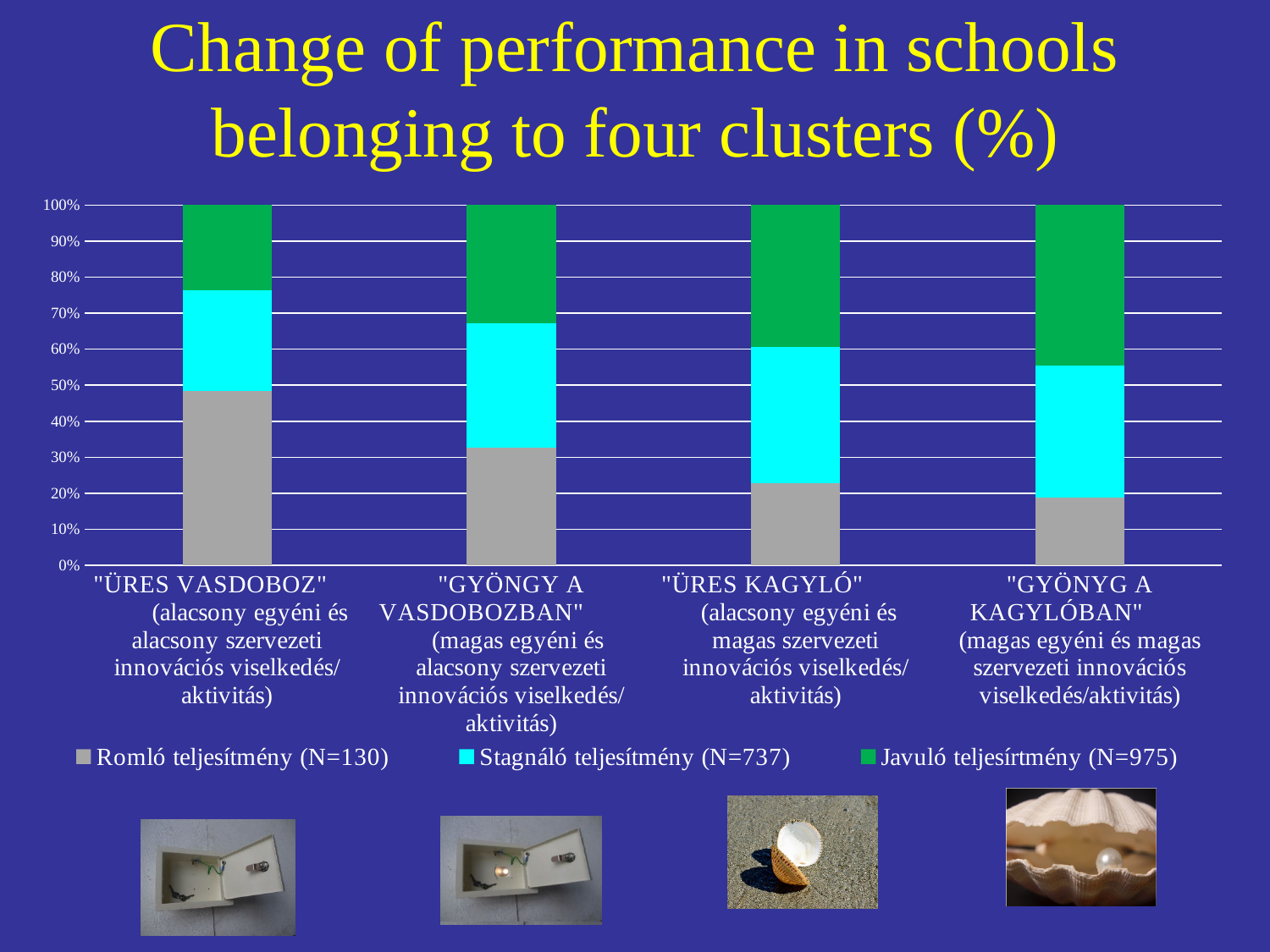
Is the Romló teljesítmény share for "GYÖNYG A KAGYLÓBAN" greater or less than 30%? less Is the Romló teljesítmény share for "ÜRES VASDOBOZ" greater or less than 40%? greater How many clusters (categories) are shown on the x axis? 4 Which cluster has the smallest share of Javuló teljesírtmény (green)? "ÜRES VASDOBOZ" Which cluster has the largest share of Romló teljesítmény (grey)? "ÜRES VASDOBOZ" Which cluster has the smallest share of Romló teljesítmény (grey)? "GYÖNYG A KAGYLÓBAN" What is the N value given in the legend for Stagnáló teljesítmény? N=737 Which cluster has the largest share of Javuló teljesírtmény (green)? "GYÖNYG A KAGYLÓBAN" How many series does the legend list? 3 Does the share of Romló teljesítmény rise or fall moving from left to right across the clusters? fall What kind of chart is shown on the slide? Stacked bar chart Which has a larger Romló teljesítmény share: "ÜRES VASDOBOZ" or "GYÖNGY A VASDOBOZBAN"? "ÜRES VASDOBOZ"